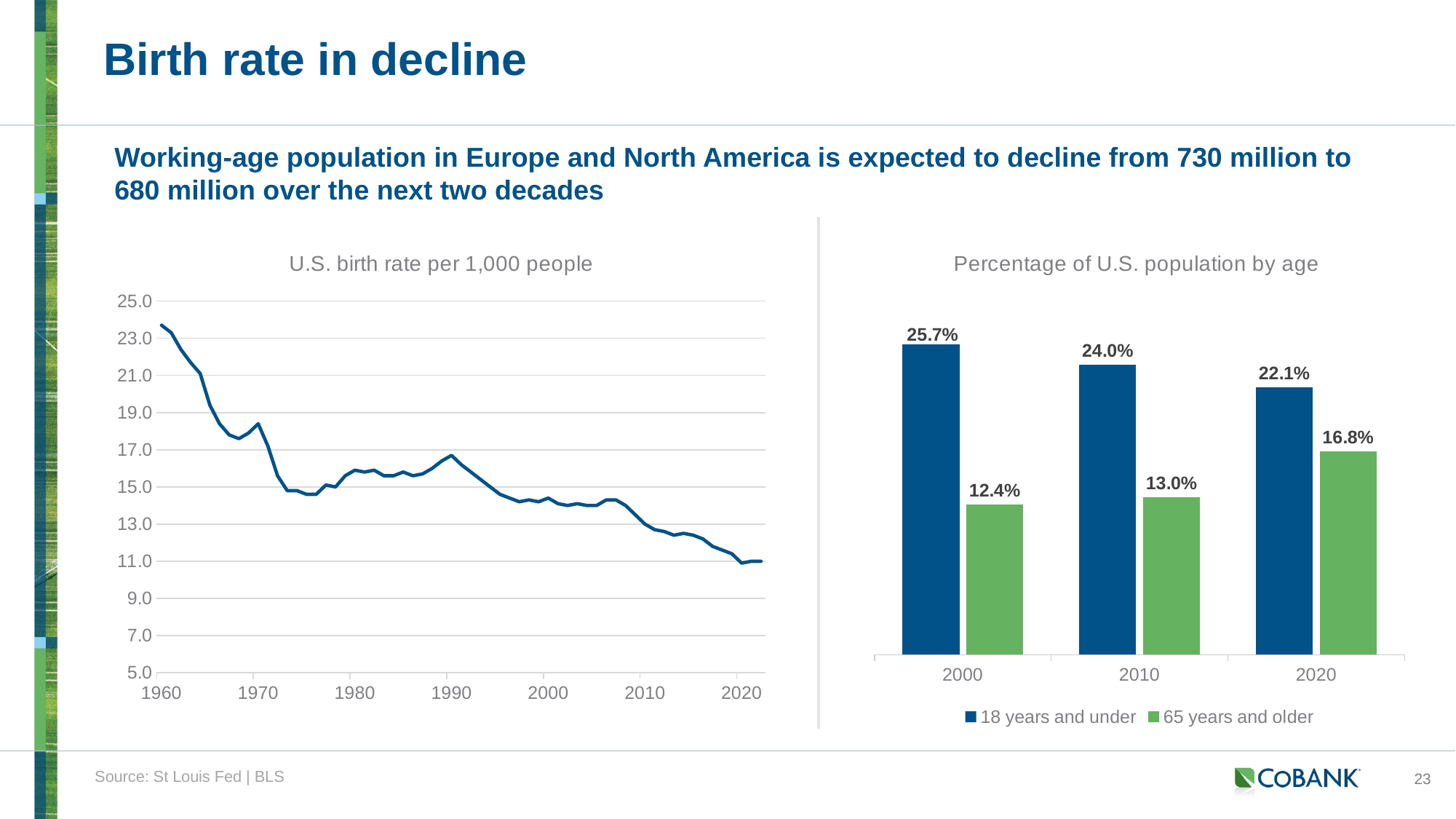
In the 'Percentage of U.S. population by age' chart, what is the value for 18 years and under in 2000? 25.7% In the 'Percentage of U.S. population by age' chart, how many series does the legend list? 2 In the 'Percentage of U.S. population by age' chart, how many years are shown on the x axis? 3 In the 'Percentage of U.S. population by age' chart, what is the value for 65 years and older in 2010? 13.0% In the 'Percentage of U.S. population by age' chart, which year has the highest value for 65 years and older? 2020 In the 'U.S. birth rate per 1,000 people' chart, do values generally rise or fall from 1960 to 2020? fall In the 'Percentage of U.S. population by age' chart, which year has the lowest value for 18 years and under? 2020 In the 'Percentage of U.S. population by age' chart, what is the difference between the 18 years and under and 65 years and older values in 2000? 13.3% In the 'Percentage of U.S. population by age' chart, what is the value for 65 years and older in 2020? 16.8% In the 'U.S. birth rate per 1,000 people' chart, is the value for 1960 greater or less than 23.0? greater What type of chart is the 'Percentage of U.S. population by age' chart? bar chart What type of chart is the 'U.S. birth rate per 1,000 people' chart? line chart